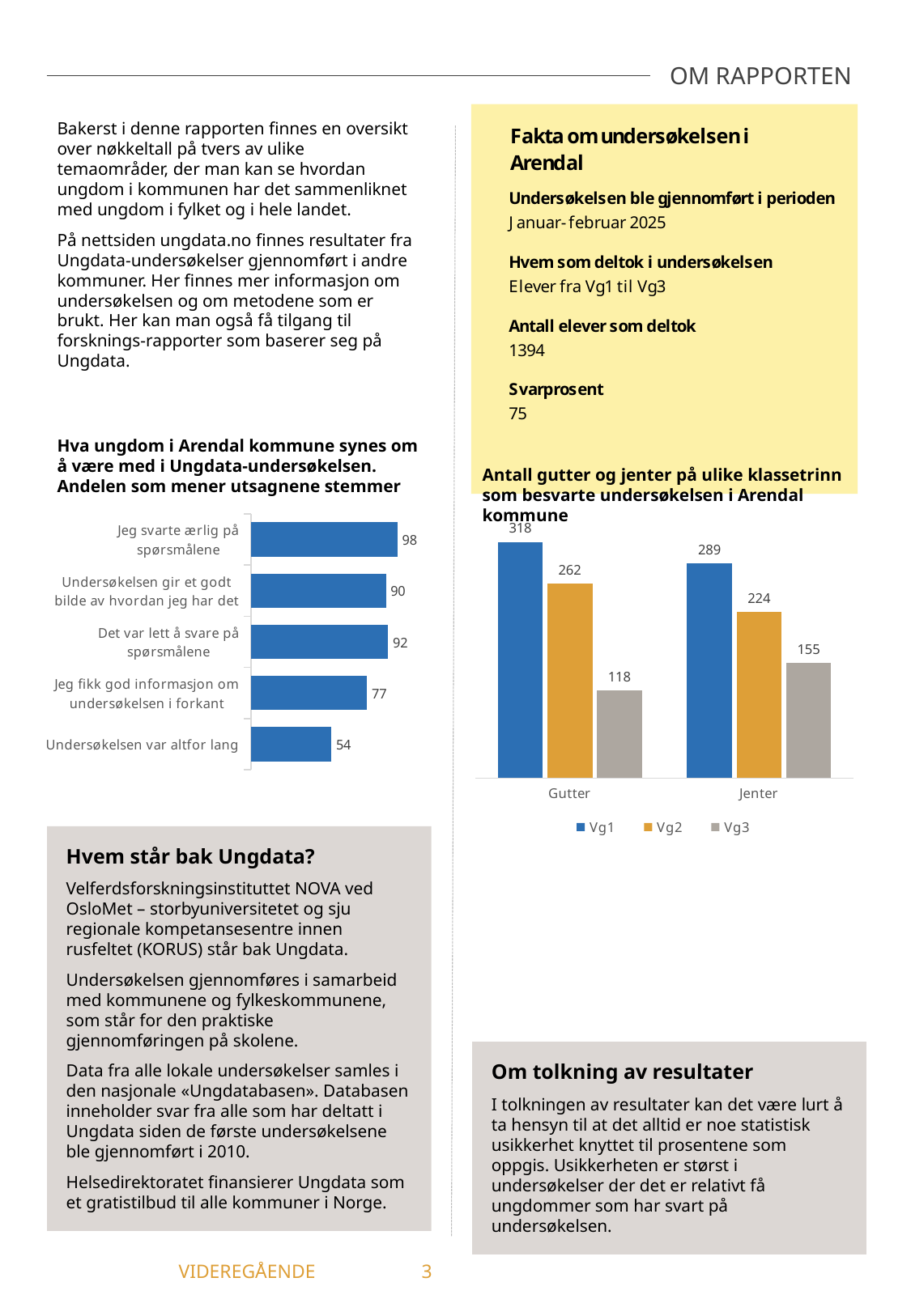
In the left chart, what is the difference between "Det var lett å svare på spørsmålene" and "Jeg fikk god informasjon om undersøkelsen i forkant"? 15 What kind of chart is the left chart? Bar chart In the right chart, what is the difference between Gutter Vg1 and Jenter Vg1? 29 In the left chart ("Hva ungdom i Arendal kommune synes om å være med i Ungdata-undersøkelsen"), what is the value for "Jeg svarte ærlig på spørsmålene"? 98 In the left chart, what is the value for "Undersøkelsen var altfor lang"? 54 In the left chart, which statement has the highest value? Jeg svarte ærlig på spørsmålene How many statements (bars) are shown in the left chart? 5 In the right chart, which is larger: Gutter Vg2 or Jenter Vg2? Gutter Vg2 In the left chart, which statement has the lowest value? Undersøkelsen var altfor lang In the right chart, what is the value for Jenter in Vg3? 155 How many series does the legend of the right chart list? 3 In the right chart ("Antall gutter og jenter på ulike klassetrinn"), what is the value for Gutter in Vg1? 318